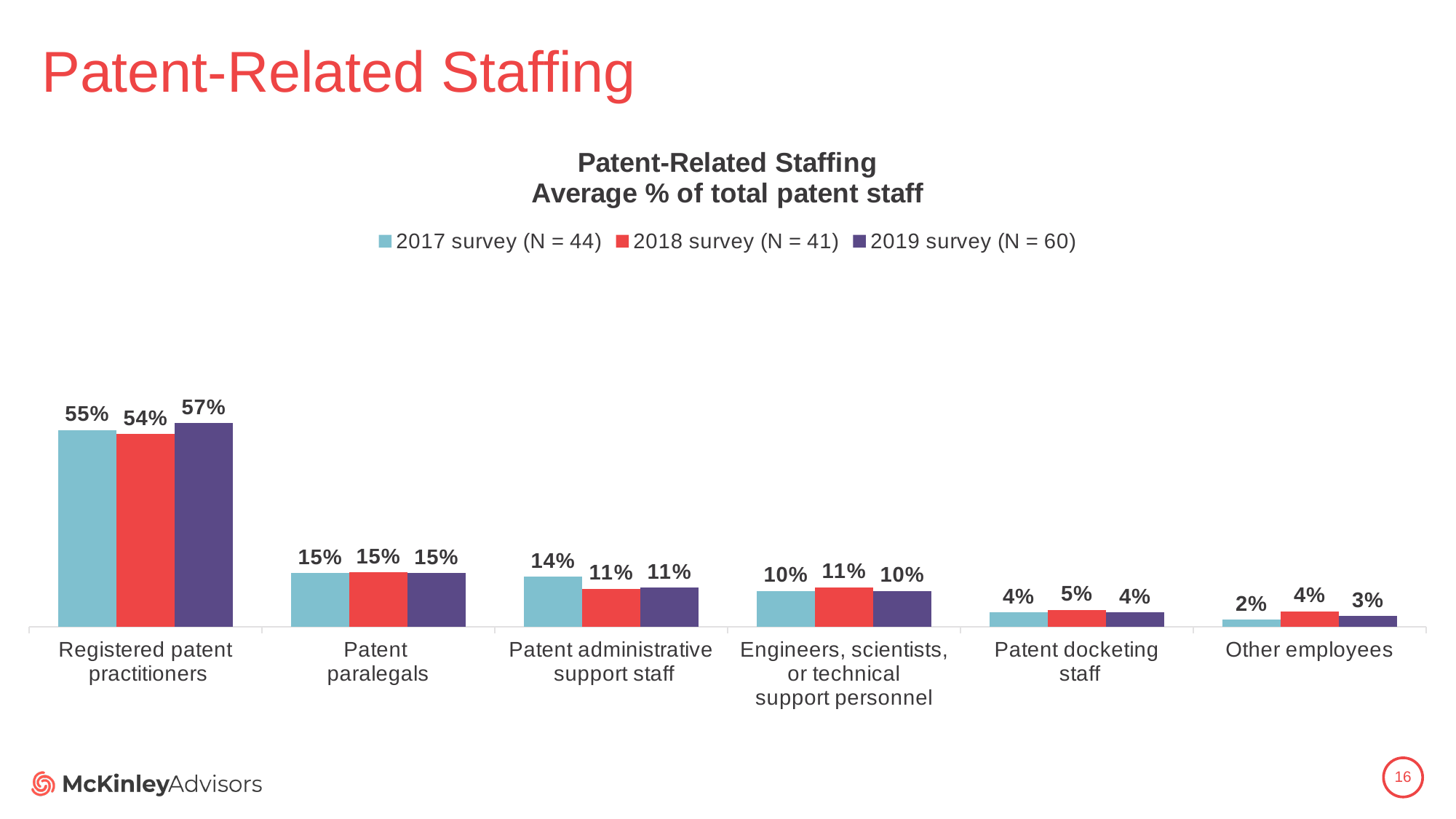
What is the value for Patent administrative support staff in the 2017 survey (N = 44)? 14% Which category has the lowest value in the 2017 survey (N = 44)? Other employees How many categories are shown on the x axis? 6 What is the difference between the 2017 survey and 2019 survey values for Patent administrative support staff? 3% Which is larger for Other employees: the 2017 survey value or the 2018 survey value? 2018 survey What is the difference between the 2019 survey and 2018 survey values for Registered patent practitioners? 3% How many series does the legend list? 3 What is the value for Registered patent practitioners in the 2019 survey (N = 60)? 57% What is the value for Patent docketing staff in the 2019 survey (N = 60)? 4% What is the value for Other employees in the 2018 survey (N = 41)? 4% What kind of chart is shown on the slide? Bar chart Which category has the highest value in the 2018 survey (N = 41)? Registered patent practitioners